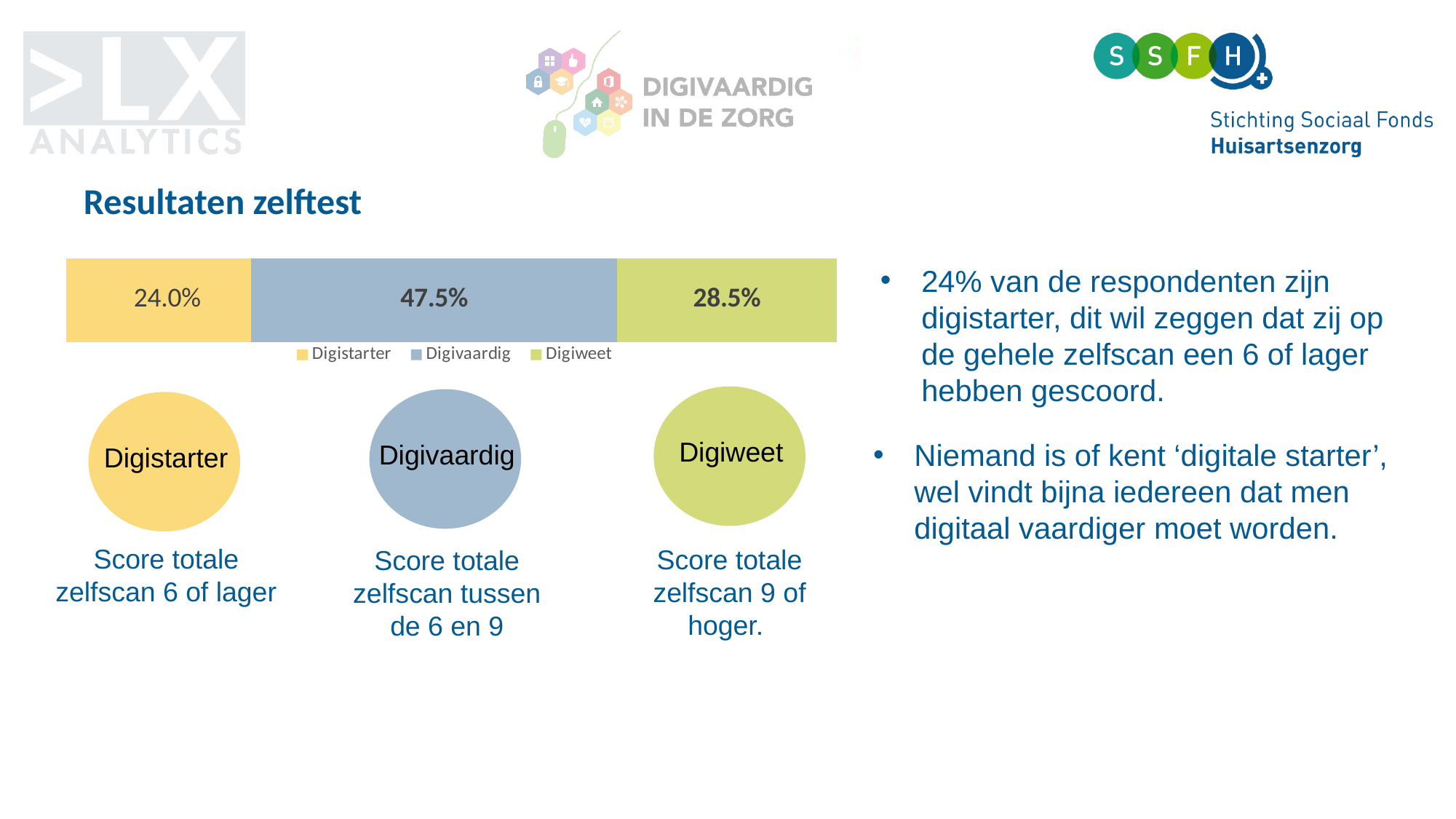
What is the difference in percentage points between Digivaardig and Digistarter? 23.5 What is the difference in percentage points between Digiweet and Digistarter? 4.5 What percentage of respondents are Digivaardig? 47.5% What percentage of respondents are Digiweet? 28.5% What kind of chart is shown on the slide? Stacked bar chart What percentage of respondents are Digistarter? 24.0% Which is larger, the share for Digiweet or the share for Digistarter? Digiweet What is the total of the three segments in the stacked bar? 100.0% Which category has the largest share in the bar? Digivaardig What colour is the Digistarter segment in the bar? Yellow Which category has the smallest share in the bar? Digistarter How many series does the legend list? 3